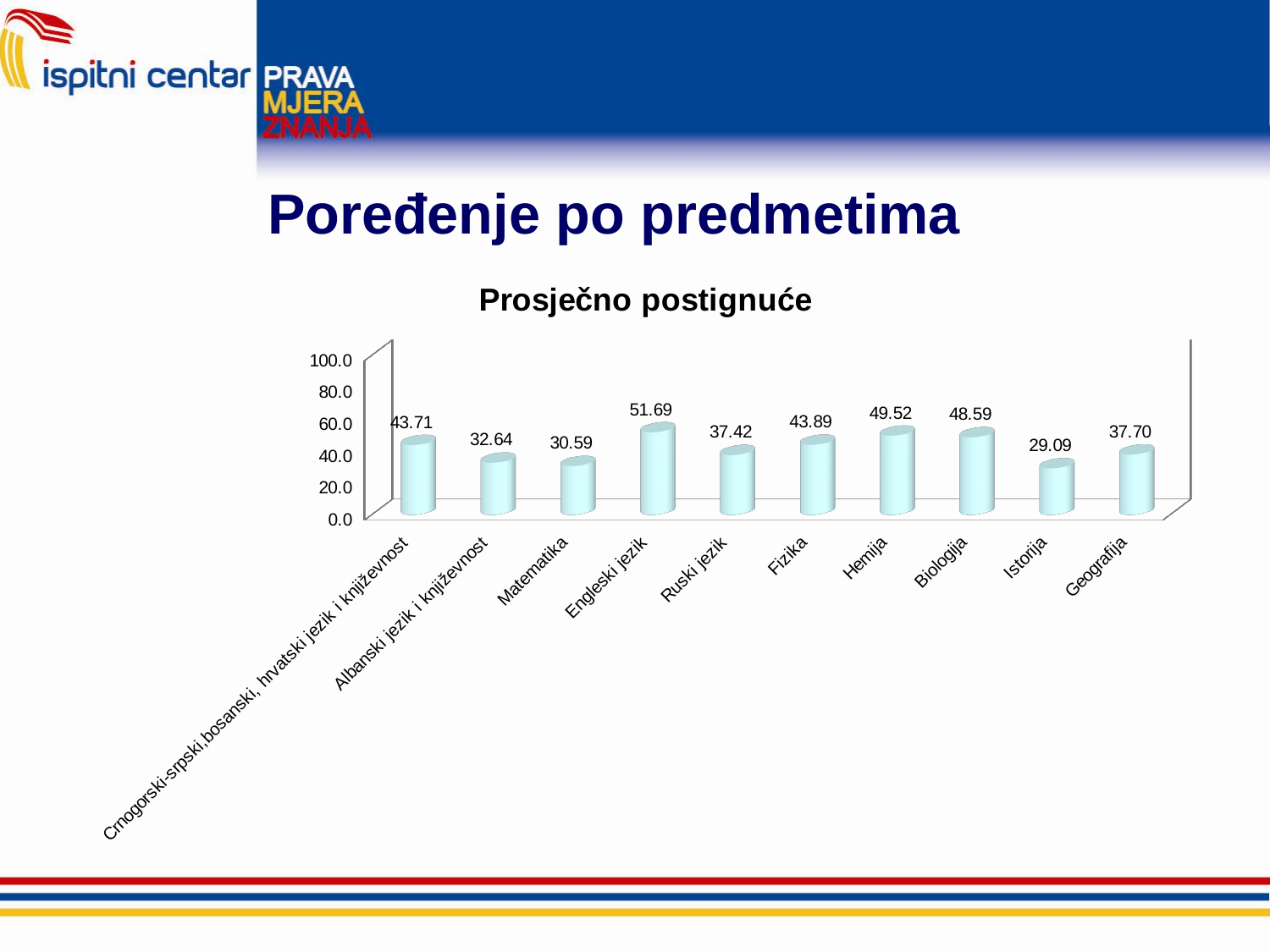
What is the title of the chart? Prosječno postignuće Which subject has the highest average achievement? Engleski jezik What is the value for Hemija? 49.52 What is the difference between the values for Hemija and Biologija? 0.93 How many subjects are shown in the chart? 10 Which is larger, the value for Fizika or the value for Ruski jezik? Fizika What is the value for Matematika? 30.59 What kind of chart is shown on the slide? bar chart What is the difference between the values for Engleski jezik and Istorija? 22.60 Is the value for Geografija greater or less than 40.0? less Which subject has the lowest average achievement? Istorija What is the value for Istorija? 29.09